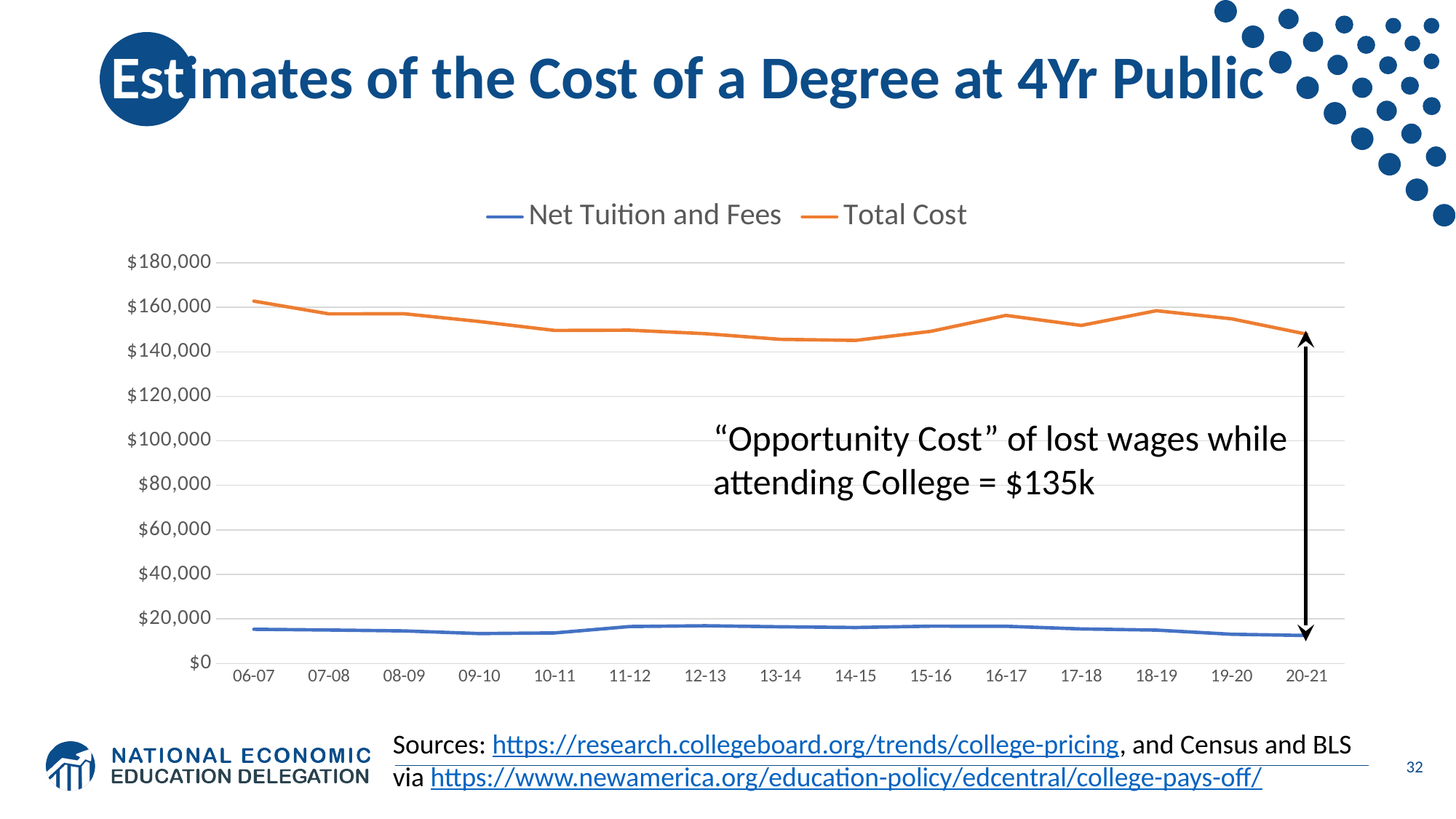
How many academic years are plotted along the x axis? 15 What kind of chart is shown on the slide? Line chart In which academic year is the Total Cost line at its highest? 06-07 What colour is the Total Cost line in the chart? Orange Does the Total Cost line rise or fall from 06-07 to 10-11? Fall Is the Net Tuition and Fees value for 06-07 greater or less than $20,000? less Is the Total Cost value for 14-15 greater or less than $160,000? less How many series does the chart's legend list? 2 In 20-21, which series has the larger value, Net Tuition and Fees or Total Cost? Total Cost What is the title of the slide? Estimates of the Cost of a Degree at 4Yr Public Is the Total Cost value for 06-07 greater or less than $160,000? greater